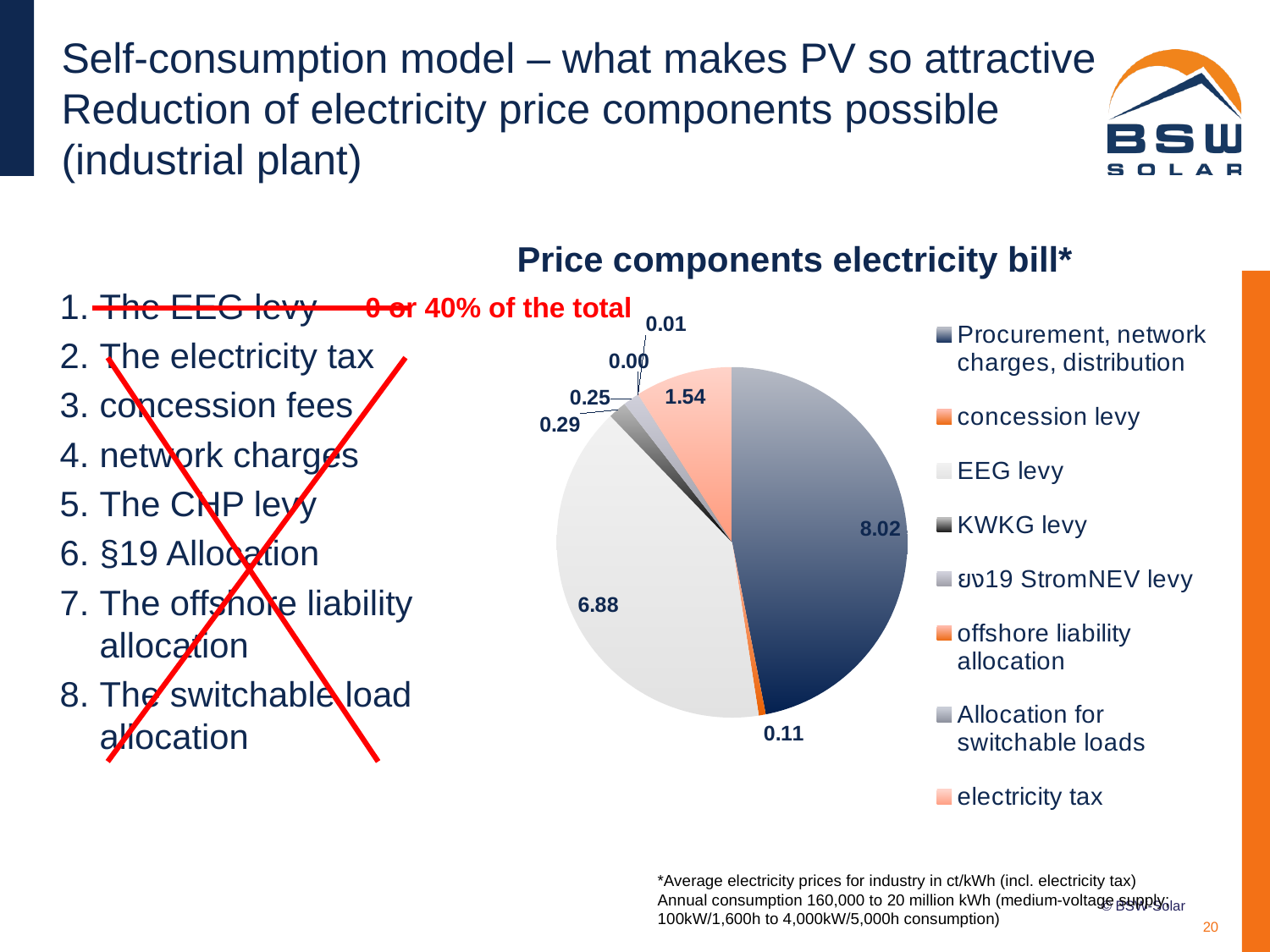
What is the difference between Procurement, network charges, distribution and the EEG levy? 1.14 What is the title of the chart? Price components electricity bill* What is the value for the electricity tax? 1.54 Which price component has the largest value? Procurement, network charges, distribution What is the value for the KWKG levy? 0.29 What is the value for Procurement, network charges, distribution? 8.02 What is the value for the EEG levy? 6.88 Which is larger, the EEG levy or the electricity tax? EEG levy What is the value for the concession levy? 0.11 How many slices does the pie chart have? 8 What kind of chart is shown on the slide? pie chart Which price component has the smallest value? offshore liability allocation